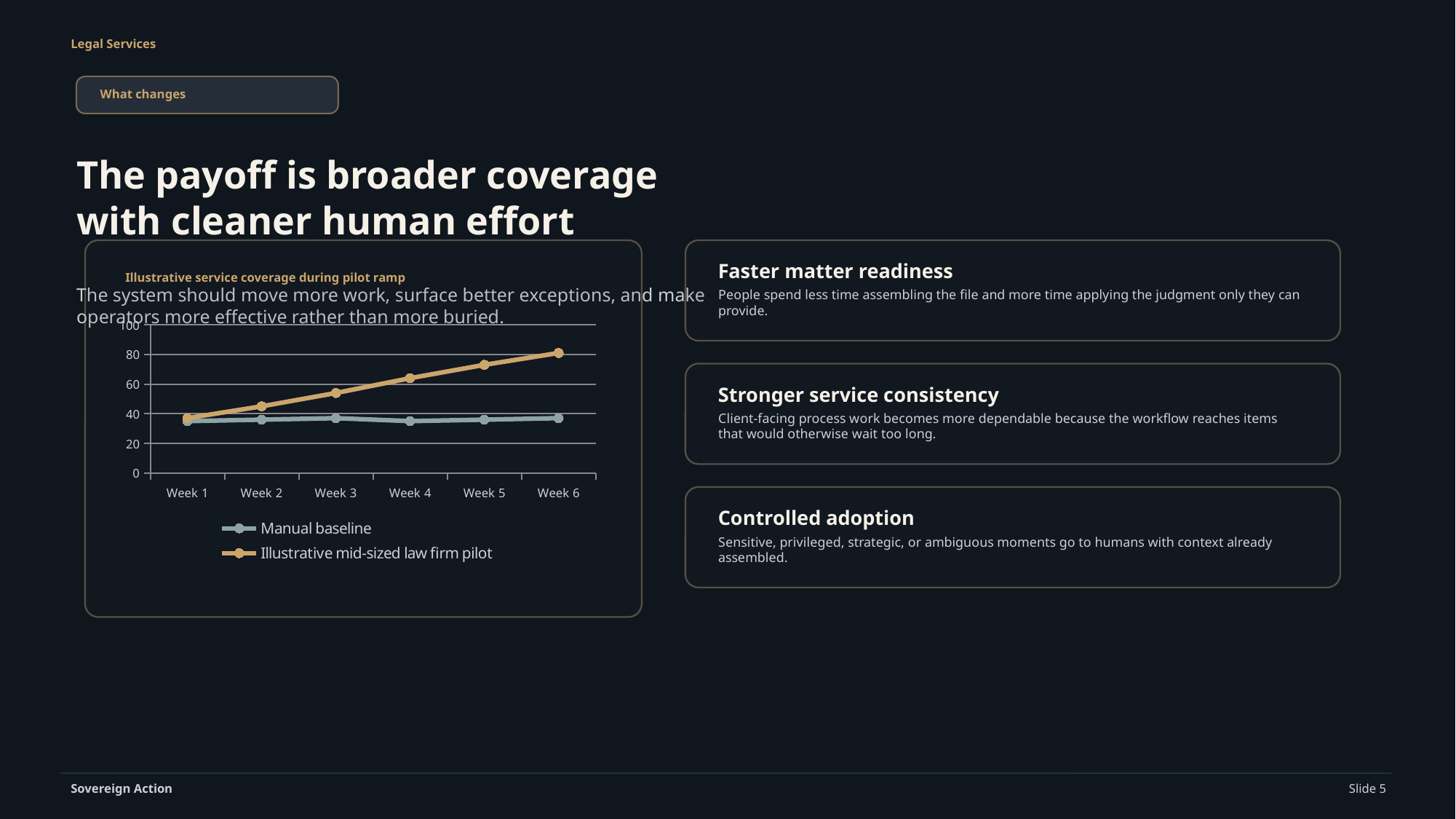
In which week is the Illustrative mid-sized law firm pilot value lowest? Week 1 Which series is drawn in the gold/orange colour? Illustrative mid-sized law firm pilot In which week is the Illustrative mid-sized law firm pilot value highest? Week 6 Is the Illustrative mid-sized law firm pilot value at Week 6 greater or less than 60? greater Is the Manual baseline value at Week 4 greater or less than 40? less How many series does the chart legend list? 2 How many weeks are plotted along the x axis? 6 At Week 6, which series has the larger value, Manual baseline or Illustrative mid-sized law firm pilot? Illustrative mid-sized law firm pilot What kind of chart is shown on the slide? Line chart Does the Illustrative mid-sized law firm pilot series rise or fall from Week 1 to Week 6? Rise Is the Illustrative mid-sized law firm pilot value at Week 3 greater or less than 40? greater What is the title of the chart? Illustrative service coverage during pilot ramp